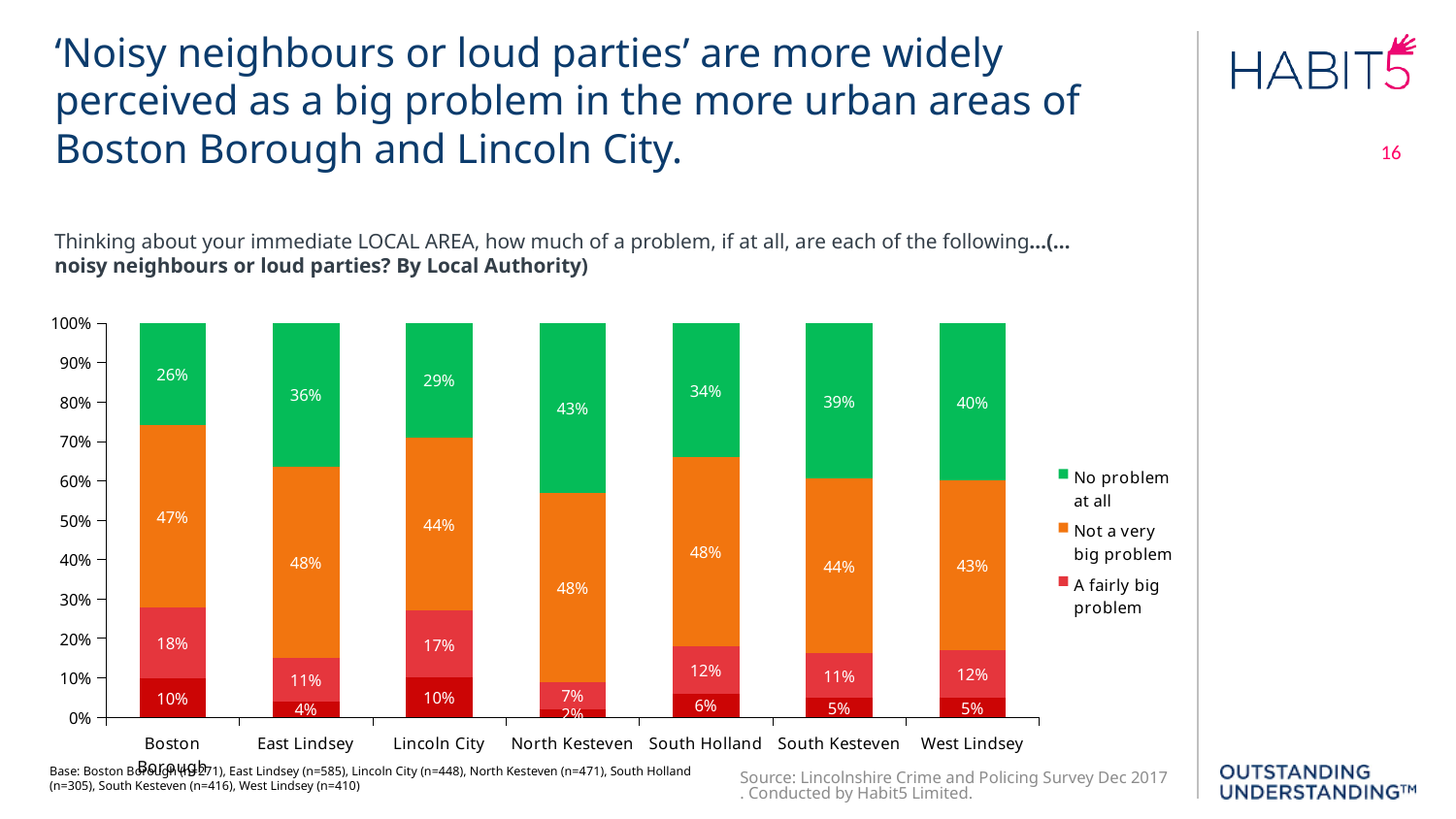
How many local authorities are shown on the x axis of the chart? 7 How many series does the chart's legend list? 3 What is the 'A fairly big problem' value for Boston Borough? 18% What is the 'Not a very big problem' value for Lincoln City? 44% Which has the larger 'A fairly big problem' value, Lincoln City or South Holland? Lincoln City Which local authority has the lowest 'No problem at all' percentage? Boston Borough Which local authority has the highest 'A fairly big problem' percentage? Boston Borough What percentage of North Kesteven respondents said noisy neighbours or loud parties are 'No problem at all'? 43% How many percentage points higher is the 'No problem at all' value for West Lindsey than for Boston Borough? 14 percentage points Which local authority has the highest 'No problem at all' percentage? North Kesteven What colour represents 'No problem at all' in the chart? Green What type of chart is shown on the slide? Stacked bar chart